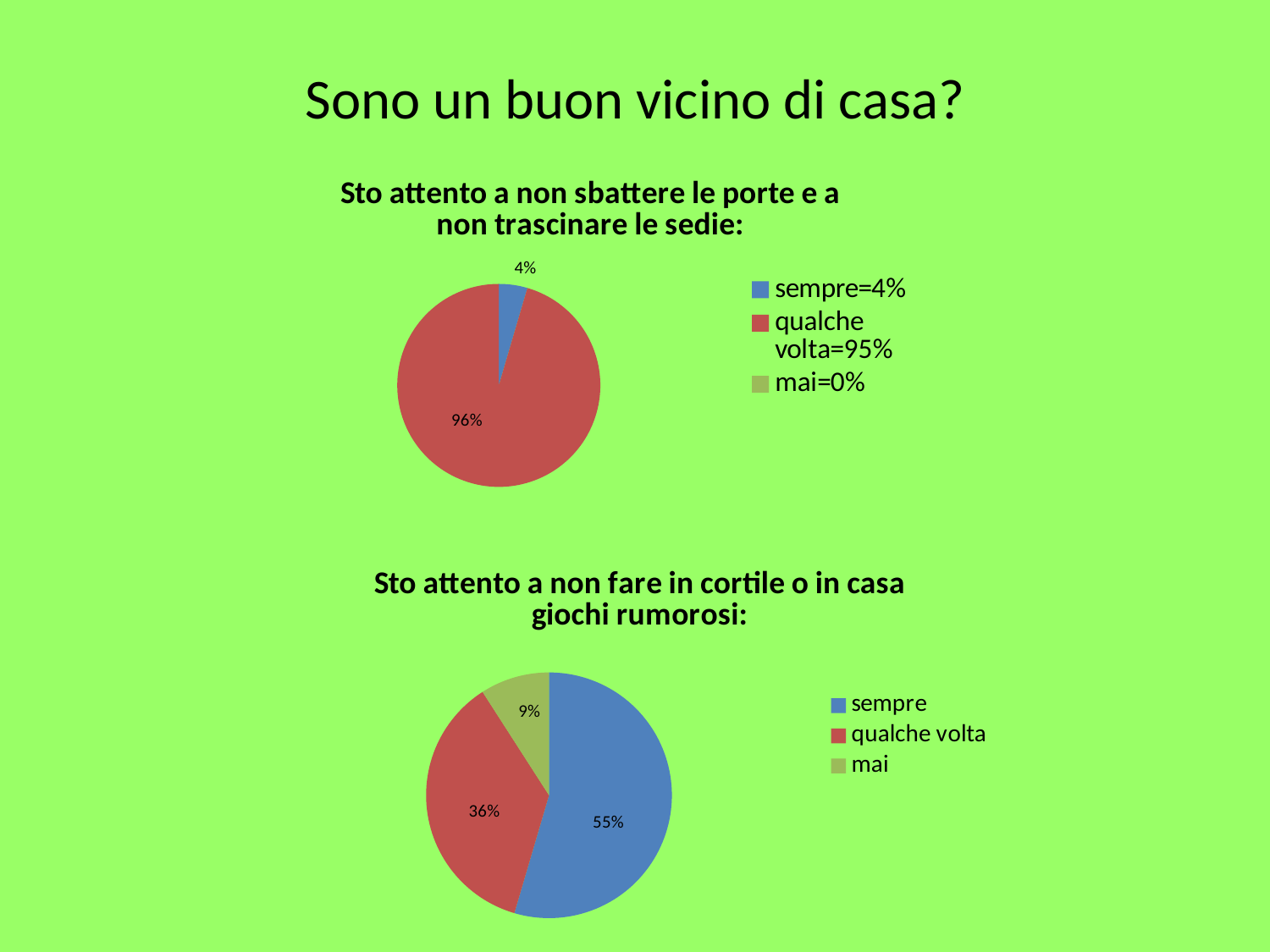
In the bottom chart (Sto attento a non fare in cortile o in casa giochi rumorosi), what is the difference in percentage points between 'sempre' and 'qualche volta'? 19 In the bottom chart (Sto attento a non fare in cortile o in casa giochi rumorosi), what percentage is shown for 'sempre'? 55% In the top chart (Sto attento a non sbattere le porte e a non trascinare le sedie), what percentage is shown for the 'sempre' slice? 4% In the bottom chart (Sto attento a non fare in cortile o in casa giochi rumorosi), which is larger, 'qualche volta' or 'mai'? qualche volta In the top chart (Sto attento a non sbattere le porte e a non trascinare le sedie), what kind of chart is used? pie chart In the top chart (Sto attento a non sbattere le porte e a non trascinare le sedie), how many entries does the legend list? 3 In the bottom chart (Sto attento a non fare in cortile o in casa giochi rumorosi), which category has the smallest slice? mai In the top chart (Sto attento a non sbattere le porte e a non trascinare le sedie), which category has the largest slice? qualche volta In the bottom chart (Sto attento a non fare in cortile o in casa giochi rumorosi), what percentage is shown for 'qualche volta'? 36% In the bottom chart (Sto attento a non fare in cortile o in casa giochi rumorosi), what colour is the 'sempre' slice? blue In the top chart (Sto attento a non sbattere le porte e a non trascinare le sedie), what percentage does the legend give for 'mai'? 0% In the bottom chart (Sto attento a non fare in cortile o in casa giochi rumorosi), what percentage is shown for 'mai'? 9%